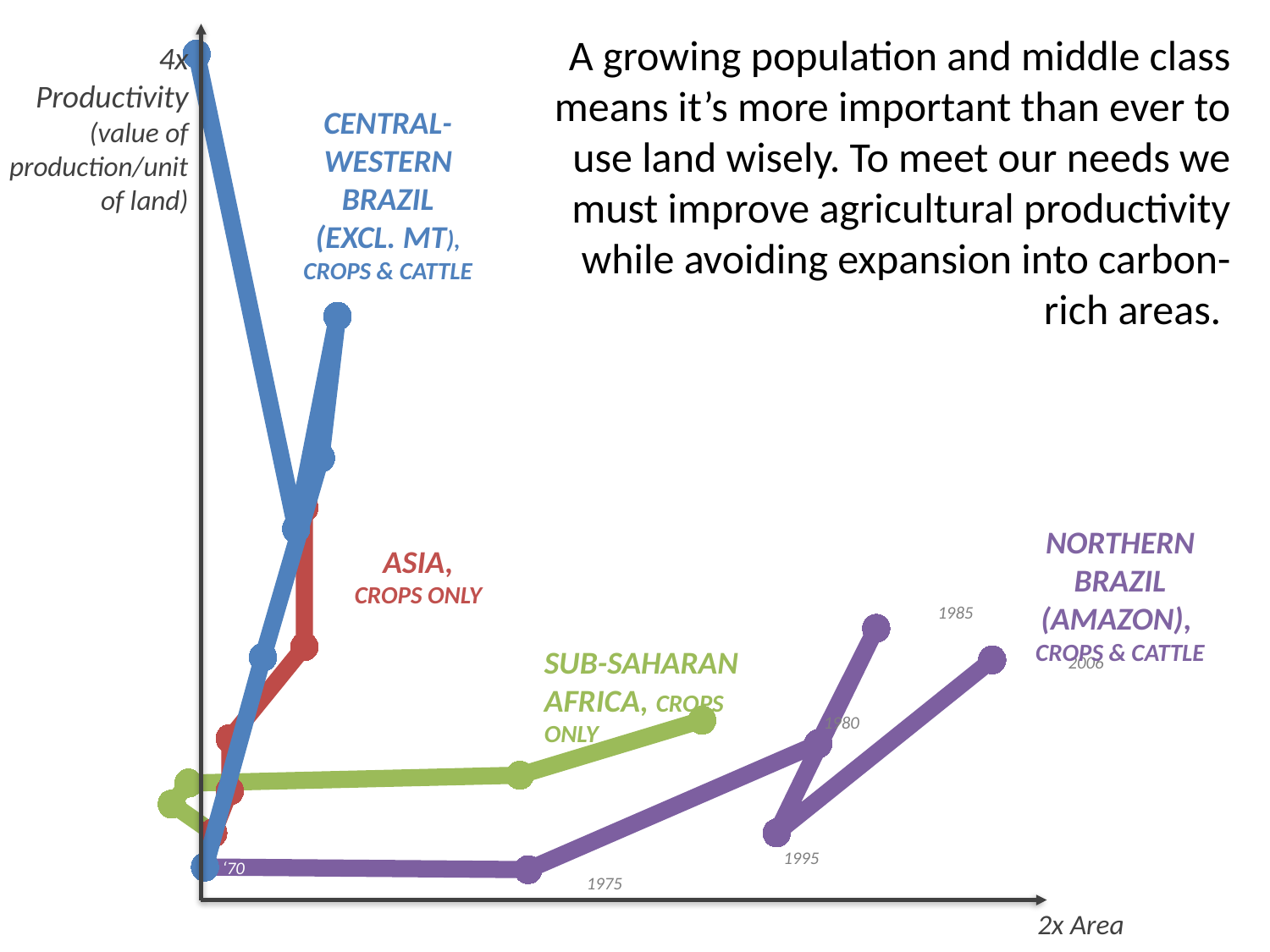
Which series reaches the highest productivity on the chart? Central-Western Brazil (excl. MT), crops & cattle How many regional series are labelled on the chart? 4 What label appears at the right end of the horizontal axis? 2x Area Which series is drawn in red? Asia, crops only What kind of chart is shown on the slide? Line chart Which series extends furthest to the right along the area axis? Northern Brazil (Amazon), crops & cattle Does the Sub-Saharan Africa line rise or fall as area increases from its middle point to its right-most point? Rise What is the label on the vertical axis of the chart? Productivity (value of production/unit of land) What value is marked at the top of the productivity axis? 4x How many year labels are printed along the Northern Brazil (Amazon) line? 6 What is the latest year labelled on the Northern Brazil (Amazon) line? 2006